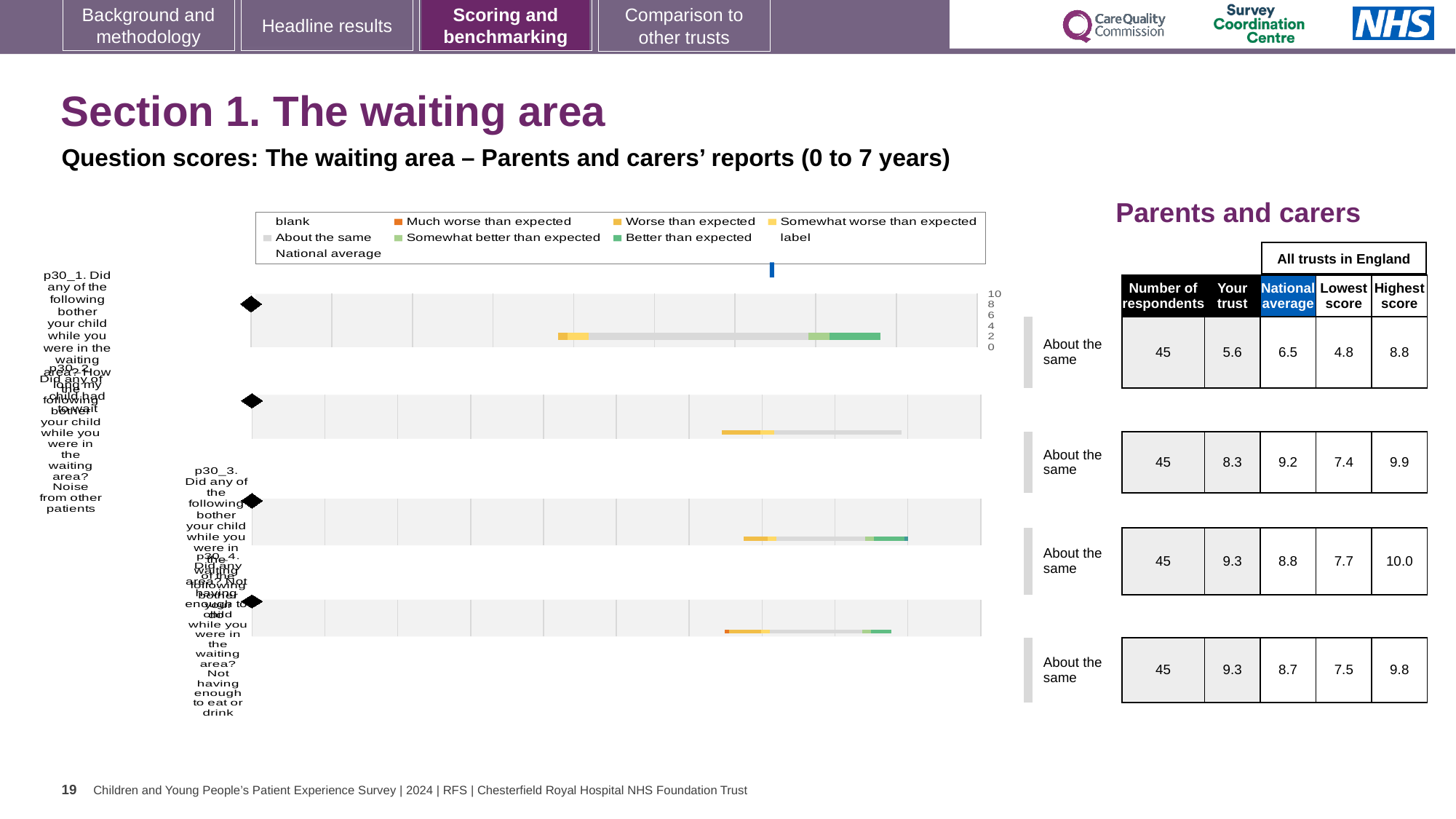
What is the 'Your trust' score for question p30_1 (bother from long wait)? 5.6 For question p30_2, which is larger: the 'Your trust' score or the national average? National average How many questions (bars) are plotted in the chart? 4 Which question has the lowest 'Your trust' score? p30_1 (bother from long wait) In the chart legend, what colour represents 'Better than expected'? green In the chart legend, which entry is shown with a dark blue marker? National average How many respondents answered each of the four waiting area questions? 45 What is the difference between the national average and the 'Your trust' score for question p30_1? 0.9 What is the national average score for question p30_2 (noise from other patients)? 9.2 What is the highest score across all trusts in England for question p30_3 (not having enough to do)? 10.0 What is the lowest score across all trusts in England for question p30_4 (not having enough to eat or drink)? 7.5 What kind of chart is used to show the question scores on this slide? bar chart